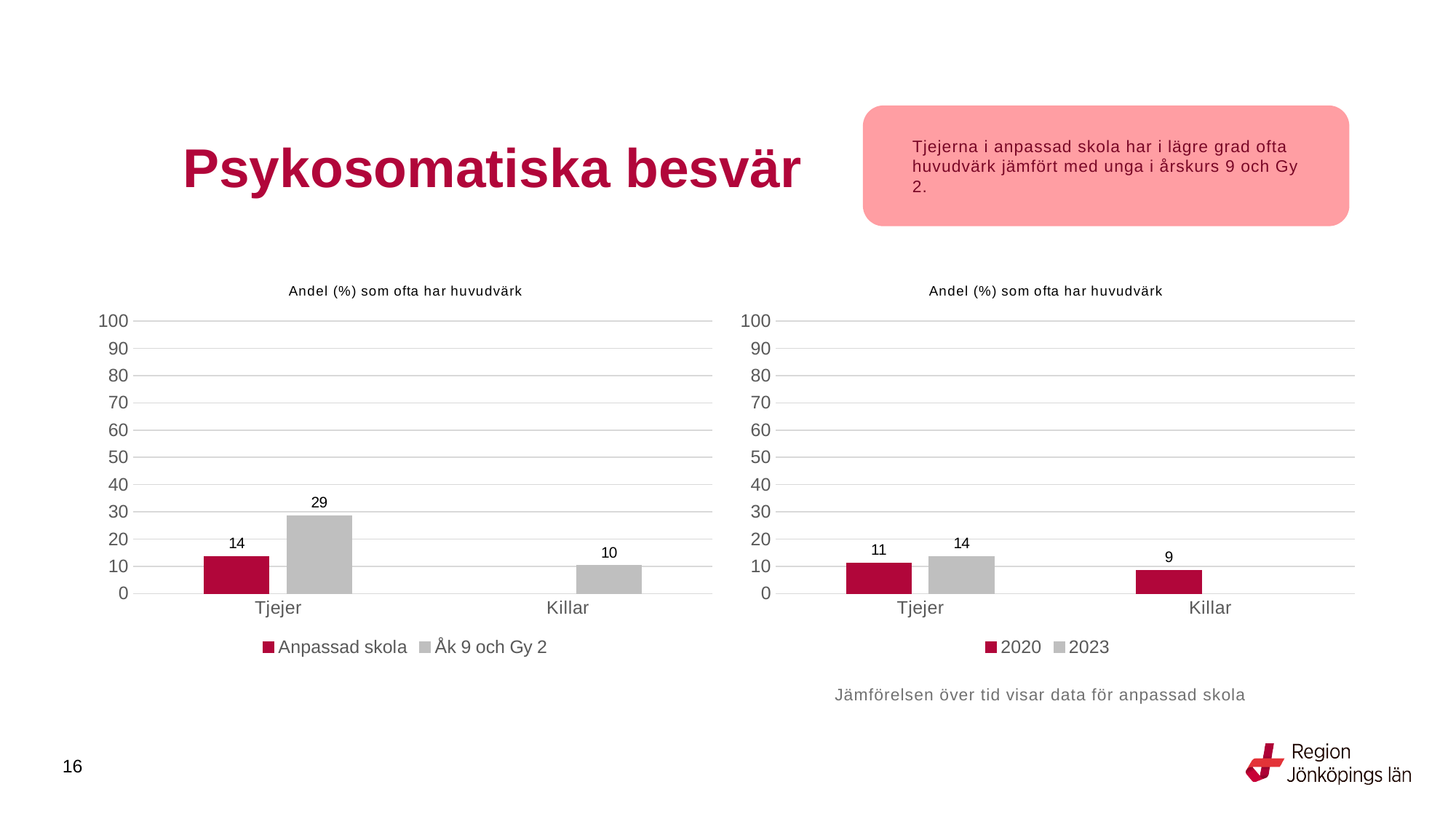
In the left chart, what is the value for Tjejer in the Anpassad skola series? 14 In the left chart, what is the value for Killar in the Åk 9 och Gy 2 series? 10 In the right chart, what is the value for Tjejer in 2020? 11 In the right chart, what is the value for Killar in 2020? 9 In the right chart, what is the value for Tjejer in 2023? 14 In the left chart, what is the value for Tjejer in the Åk 9 och Gy 2 series? 29 In the left chart, what is the difference between the Åk 9 och Gy 2 and Anpassad skola values for Tjejer? 15 In the left chart, which series has the higher value for Tjejer? Åk 9 och Gy 2 What kind of chart is the left chart? Bar chart How many series does the legend of the right chart list? 2 In the right chart, is the value for Killar in 2020 greater or less than 10? less In the right chart, what is the difference between the 2023 and 2020 values for Tjejer? 3